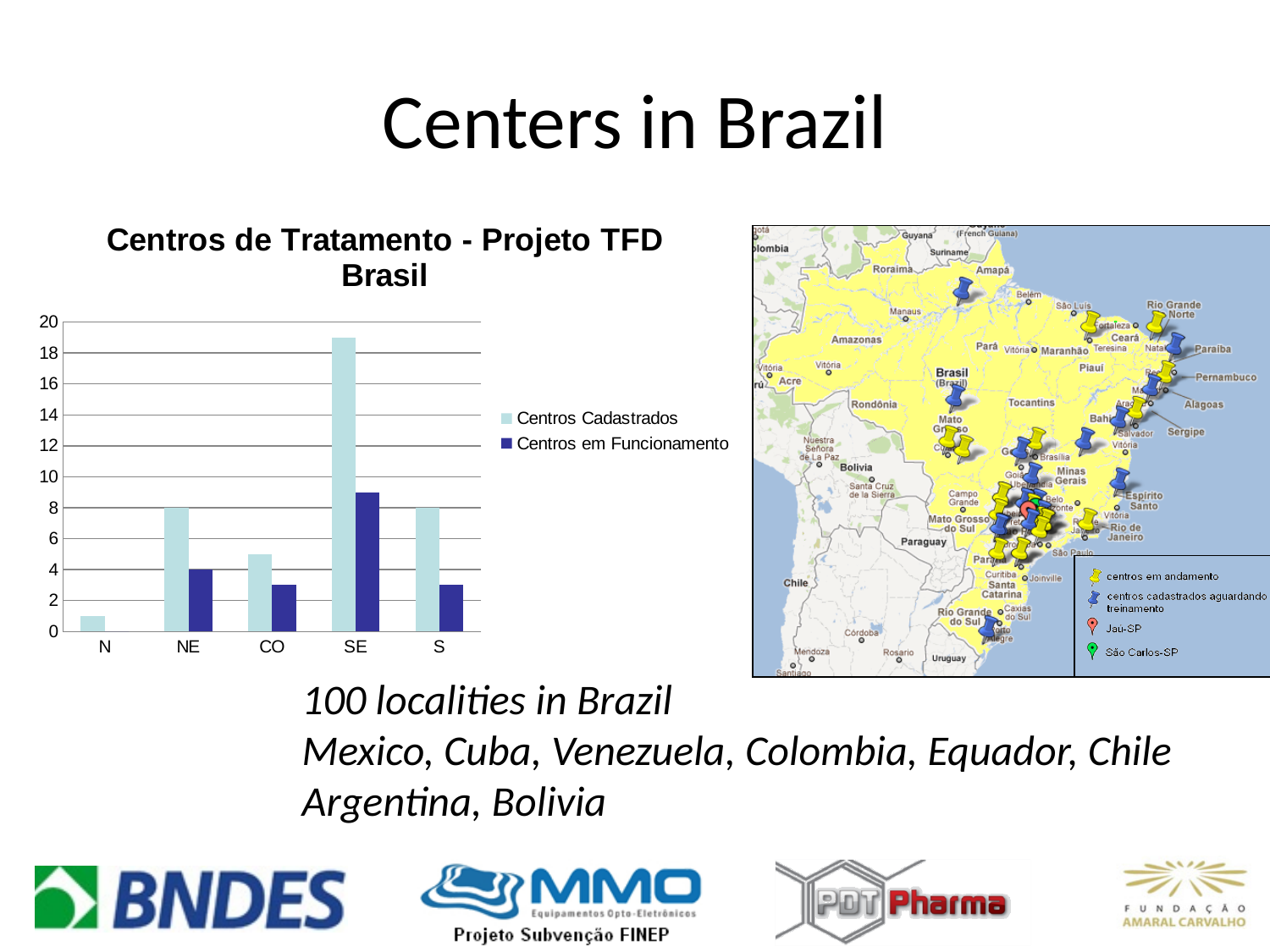
Which region has the highest value for Centros Cadastrados? SE What is the value of Centros Cadastrados for S? 8 Which is larger, Centros Cadastrados for SE or Centros Cadastrados for NE? SE What kind of chart is shown on the slide? bar chart Is the value of Centros em Funcionamento for CO greater or less than 4? less What is the value of Centros Cadastrados for NE? 8 How many categories are shown on the x axis of the chart? 5 How many series does the chart's legend list? 2 What is the title of the chart on the slide? Centros de Tratamento - Projeto TFD Brasil Is the value of Centros Cadastrados for SE greater or less than 18? greater What is the value of Centros em Funcionamento for NE? 4 Which region has the lowest value for Centros Cadastrados? N